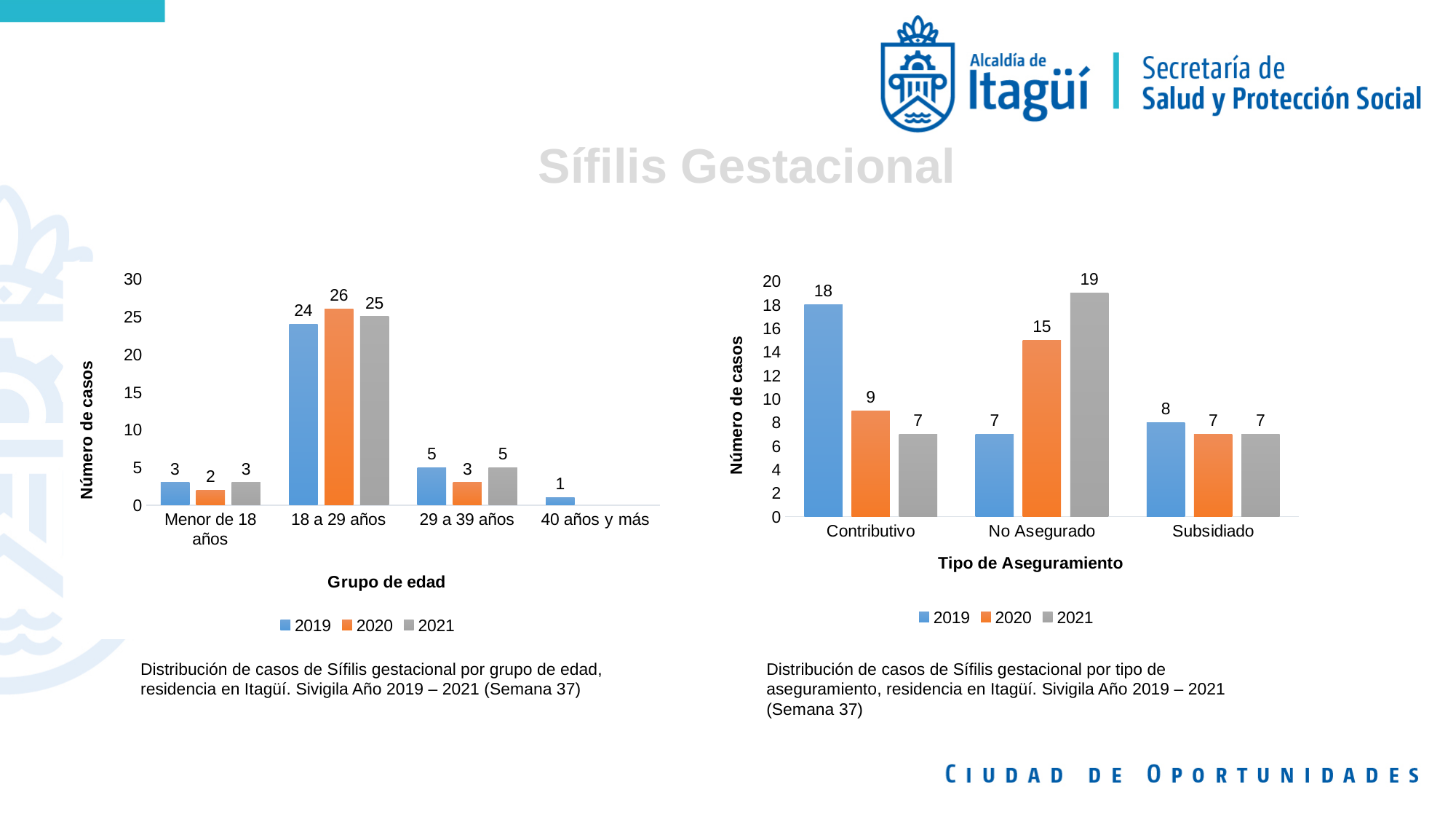
In the right chart (by type of insurance), what is the difference between Contributivo in 2019 and Contributivo in 2021? 11 How many series does the legend of the right chart (by type of insurance) list? 3 In the left chart (by age group), how many age groups are shown on the x axis? 4 In the left chart (by age group), how many cases were there for 18 a 29 años in 2020? 26 In the left chart (by age group), which age group has the highest number of cases in 2021? 18 a 29 años In the left chart (by age group), what is the difference between the 2020 and 2019 values for 18 a 29 años? 2 In the right chart (by type of insurance), which category has the highest value in 2019? Contributivo In the left chart (by age group), what is the value for 40 años y más in 2019? 1 In the left chart (by age group), how many cases were there for Menor de 18 años in 2019? 3 What type of chart is the left chart (by age group)? Bar chart In the right chart (by type of insurance), which is larger: Contributivo in 2020 or Subsidiado in 2020? Contributivo in 2020 In the right chart (by type of insurance), how many cases were there for No Asegurado in 2021? 19